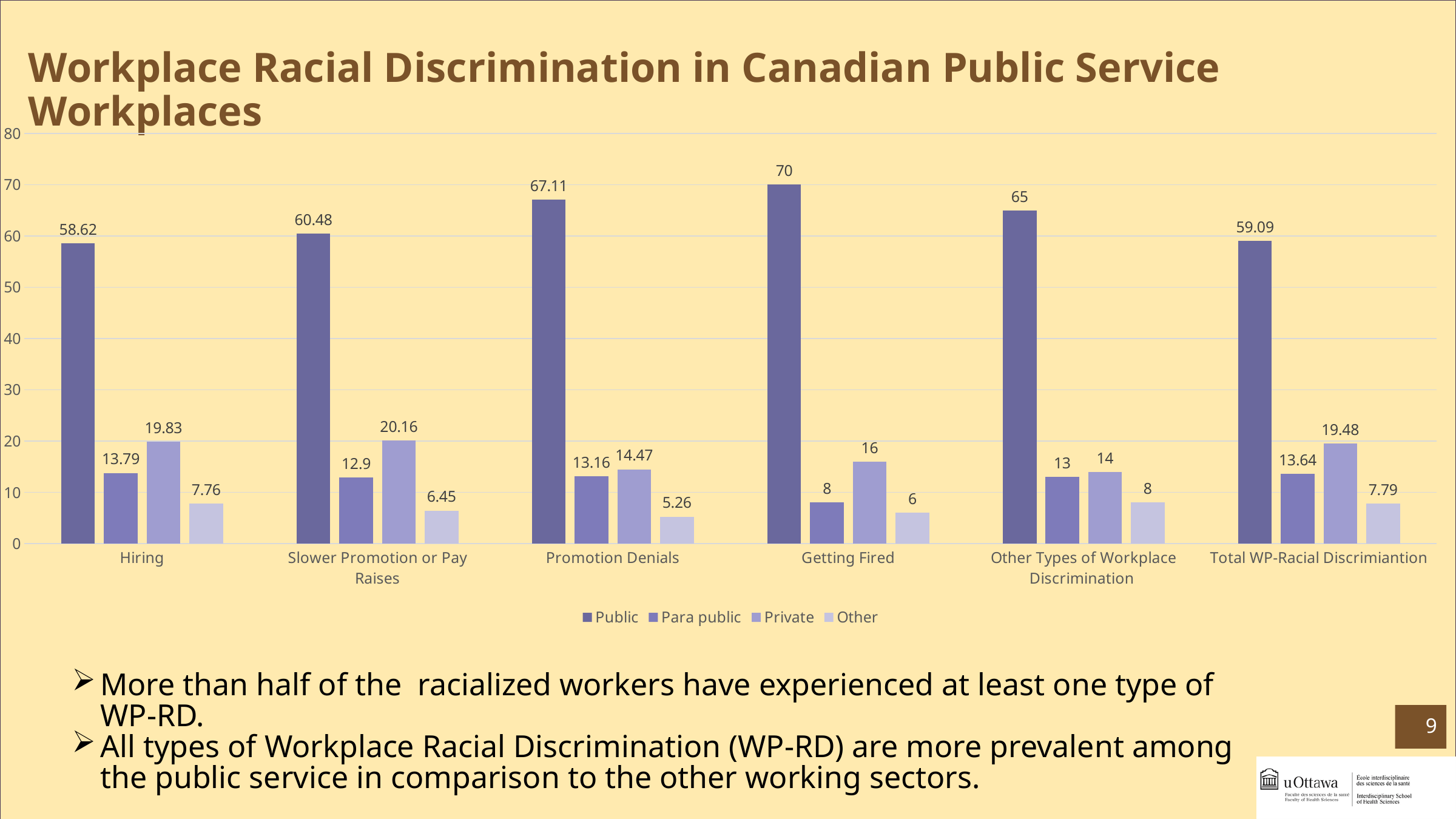
What is the difference between the Public and Private values in the Getting Fired category? 54 What is the value for Public in the Hiring category? 58.62 What kind of chart is shown on the slide? bar chart Which is larger in the Promotion Denials category: the Para public value or the Private value? Private What is the value for Para public in the Total WP-Racial Discrimiantion category? 13.64 In which category is the Para public value lowest? Getting Fired In which category is the Public value highest? Getting Fired What is the value for Other in the Promotion Denials category? 5.26 How many categories are shown on the x axis? 6 How many series does the legend list? 4 What is the value for Private in the Slower Promotion or Pay Raises category? 20.16 Is the Public value for Other Types of Workplace Discrimination greater or less than 60? greater